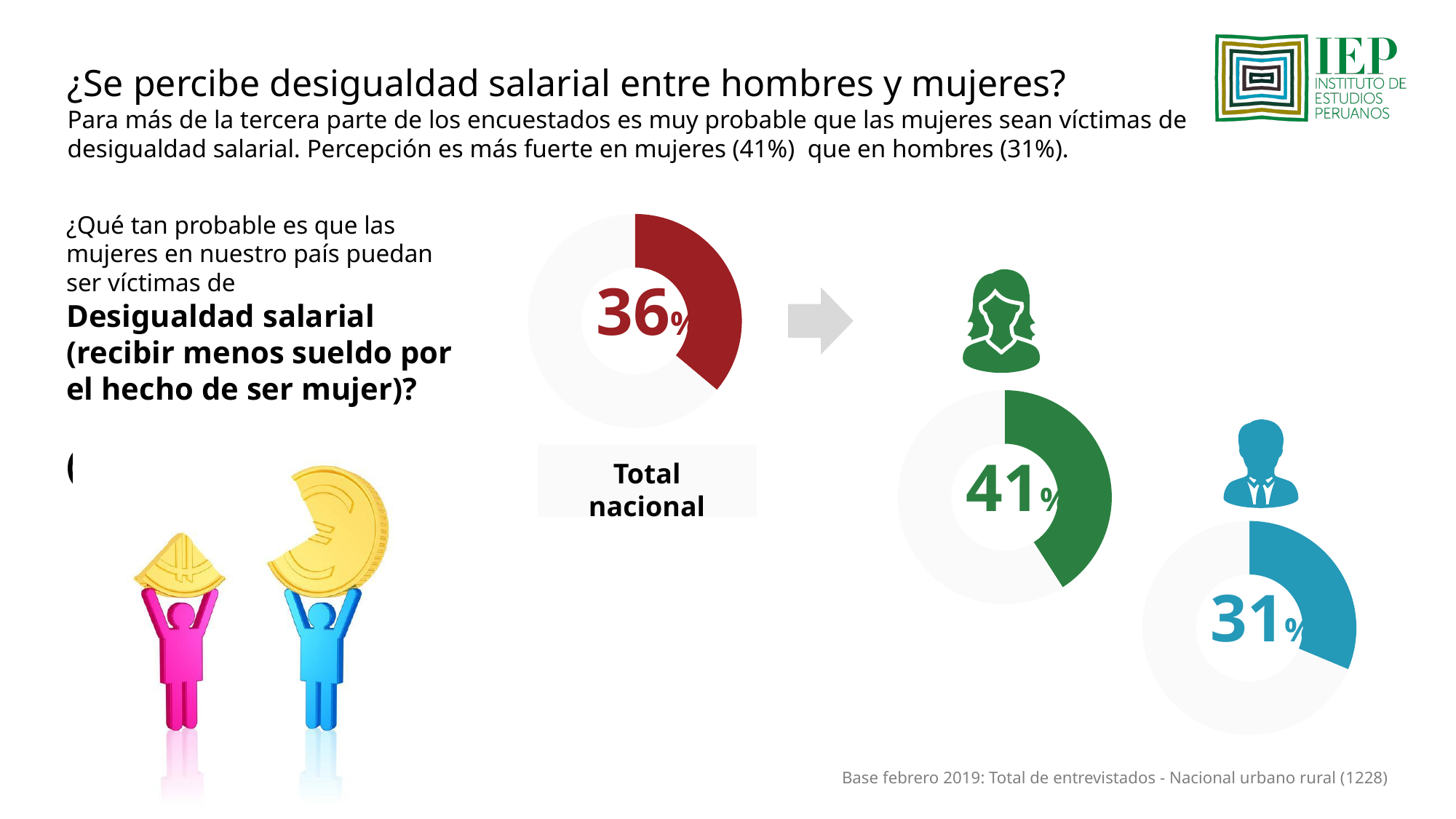
What colour is the donut chart showing the 'Total nacional' value? Dark red How many donut charts are shown on the slide? 3 Which of the three donut charts shows the highest value? The green one (women), 41% What kind of chart is used to display the 36%, 41% and 31% values? Donut chart Is the value in the green donut chart (women) larger or smaller than the value in the blue donut chart (men)? Larger What is the difference between the value for women (green chart) and the value for men (blue chart)? 10 percentage points Is the 'Total nacional' value greater or less than 50%? less What is the difference between the value for women (green chart) and the 'Total nacional' value? 5 percentage points What value is shown in the 'Total nacional' donut chart? 36% What value is shown in the blue donut chart with the man icon? 31% What value is shown in the green donut chart with the woman icon? 41% Which of the three donut charts shows the lowest value? The blue one (men), 31%